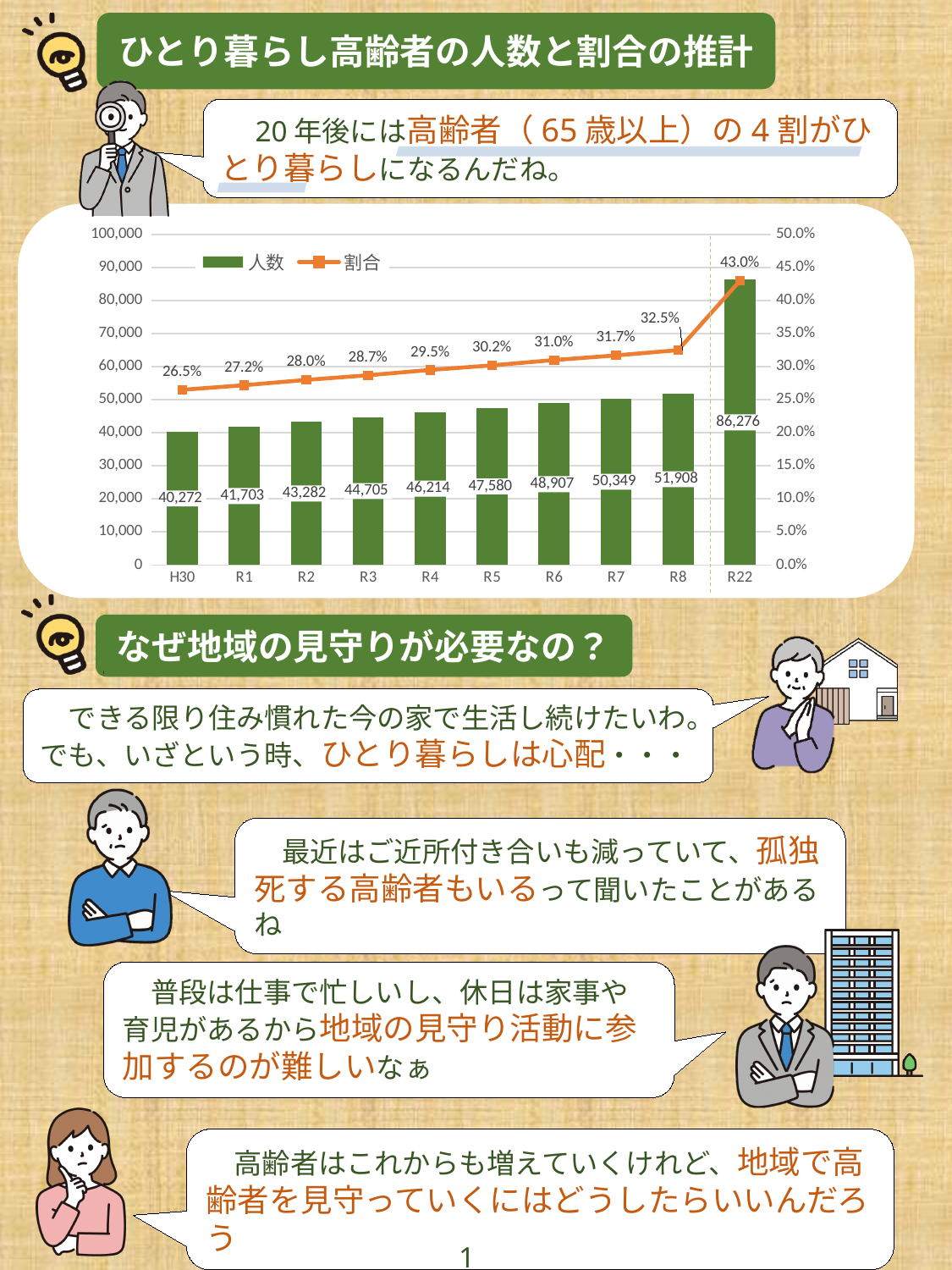
What are the two series names listed in the legend? 人数 and 割合 What is the 人数 value for R22? 86,276 Which has a larger 人数 value, R2 or R6? R6 How many categories are shown on the x axis? 10 What is the 割合 value for R8? 32.5% Which category has the lowest 割合 value? H30 What is the 割合 value for H30? 26.5% How many series does the legend list? 2 Does the 割合 line rise or fall from H30 to R22? rise What is the 人数 value for R4? 46,214 What is the difference in 人数 between R22 and R8? 34,368 Which category has the highest 人数 value? R22